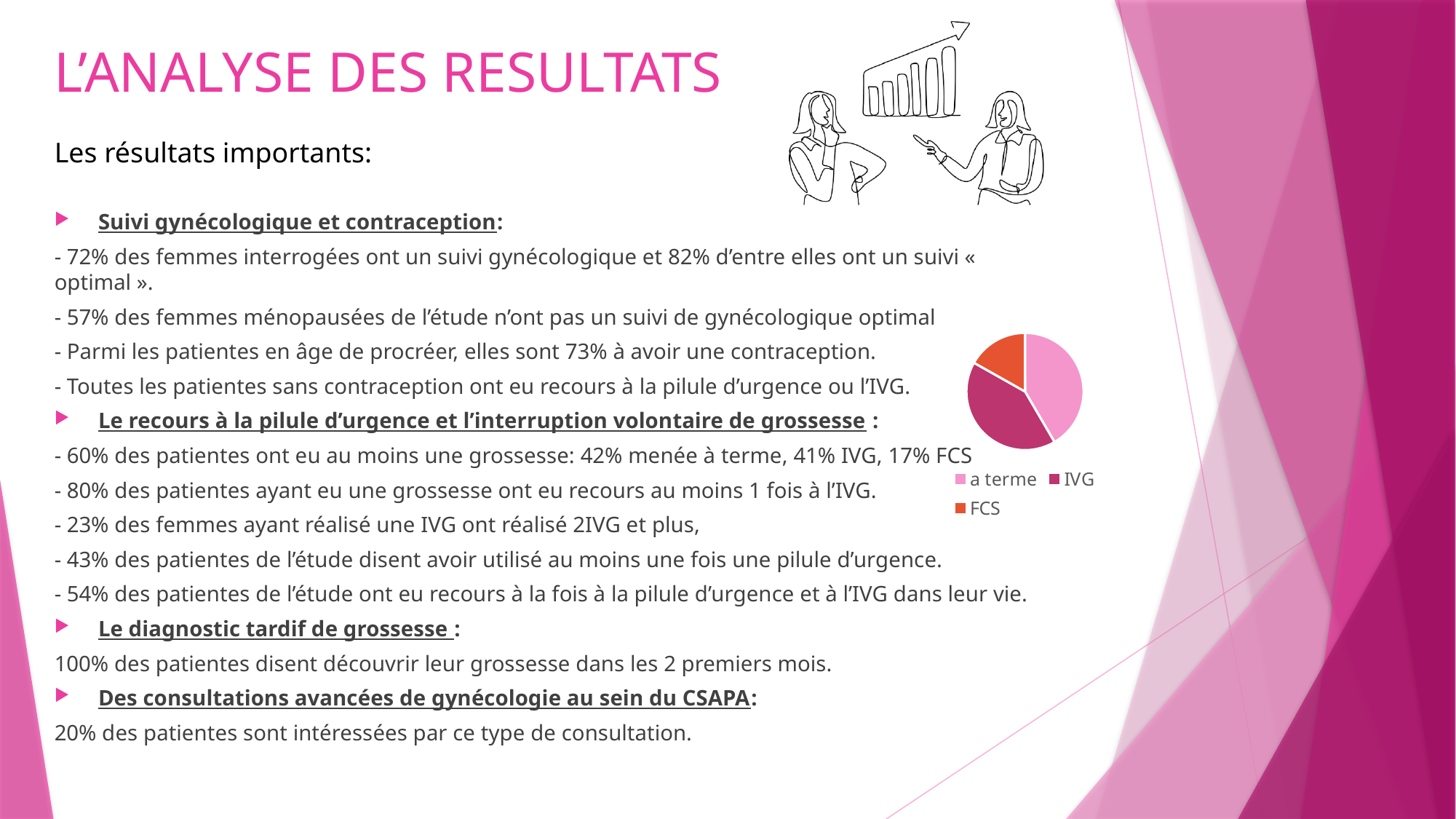
What kind of chart is shown on the slide? pie chart In the pie chart, which slice is larger: a terme or FCS? a terme What are the three categories listed in the legend of the pie chart? a terme, IVG, FCS Which category has the smallest slice in the pie chart? FCS In the pie chart, which slice is larger: IVG or FCS? IVG How many entries does the legend of the pie chart list? 3 Which legend entry of the pie chart is shown in orange-red? FCS According to the slide, what share of pregnancies does the 'a terme' slice represent? 42% According to the slide, what share of pregnancies does the 'FCS' slice represent? 17% How many slices does the pie chart have? 3 According to the slide, what share of pregnancies does the 'IVG' slice represent? 41%